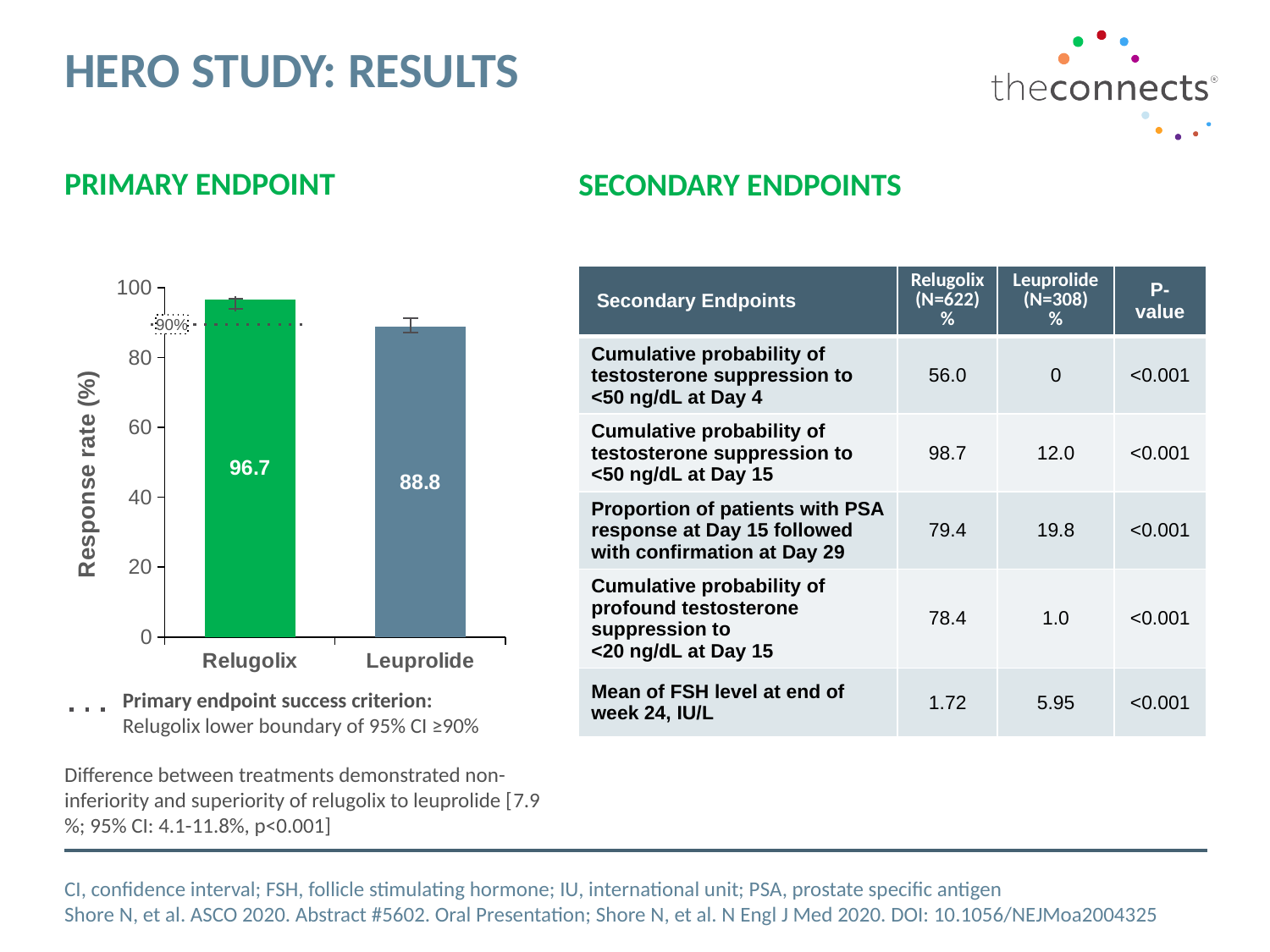
What is the difference in response rate between Relugolix and Leuprolide in the bar chart? 7.9 How many treatment groups are shown in the bar chart? 2 What type of chart is used to show the primary endpoint? Bar chart Which treatment has the higher response rate in the bar chart? Relugolix Is the response rate for Leuprolide larger than that for Relugolix? No At what value is the dotted horizontal line drawn in the bar chart? 90% Is the response rate for Relugolix greater or less than 90? greater Which treatment has the lower response rate in the bar chart? Leuprolide What is the response rate for Relugolix in the bar chart? 96.7 What is the label of the y-axis in the bar chart? Response rate (%) Is the response rate for Leuprolide greater or less than 90? less What is the response rate for Leuprolide in the bar chart? 88.8